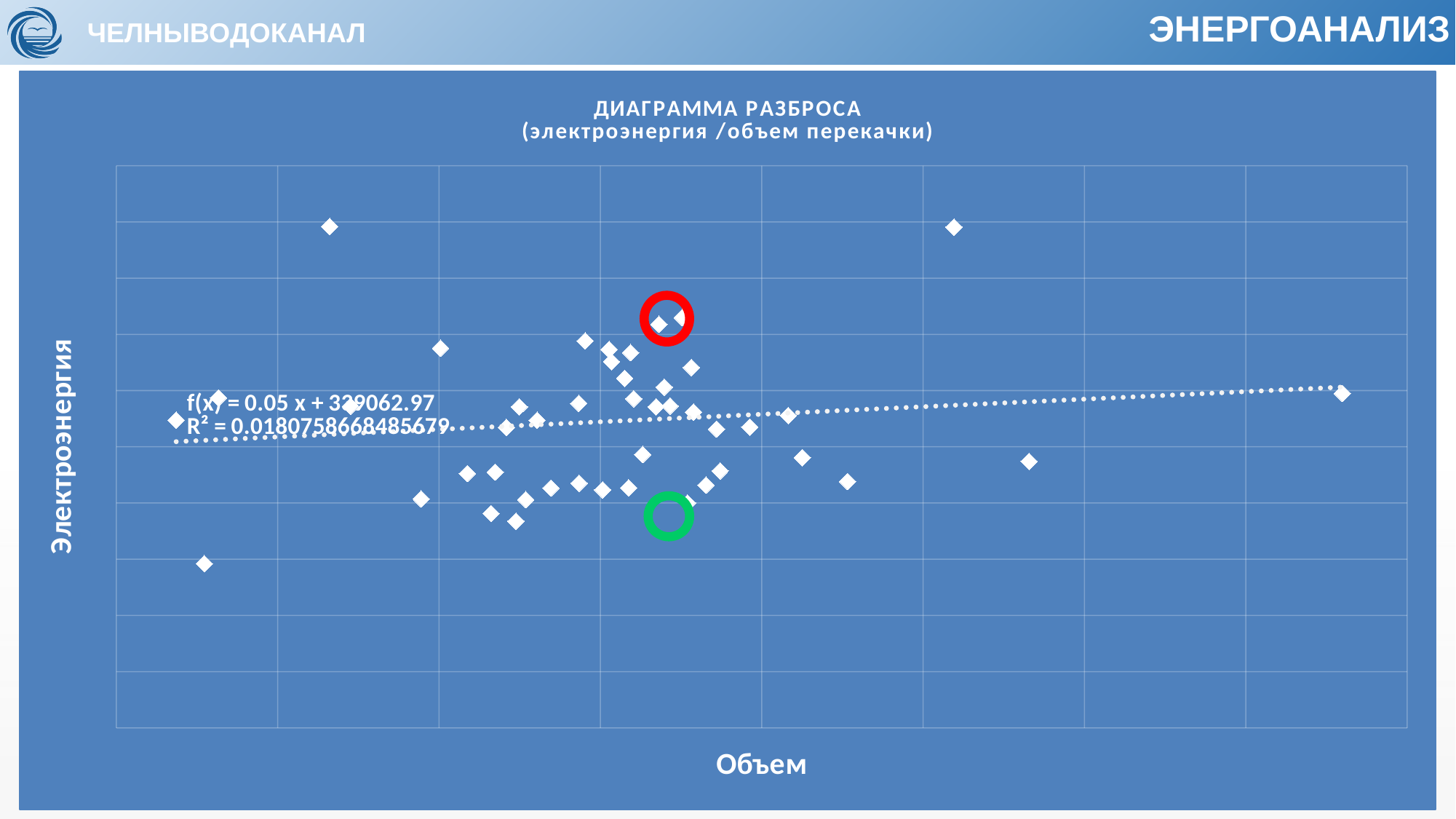
What R² value is printed on the chart? 0.0180758668485679 What is the trendline equation printed on the chart? f(x) = 0.05 x + 339062.97 What is the slope of the trendline shown in the equation on the chart? 0.05 What is the intercept of the trendline shown in the equation on the chart? 339062.97 What is the label of the horizontal axis of the chart? Объем What is the title of the chart? ДИАГРАММА РАЗБРОСА (электроэнергия /объем перекачки) Does the dotted trendline rise or fall as the volume (Объем) increases along the x axis? rise What kind of chart is shown on the slide? scatter chart